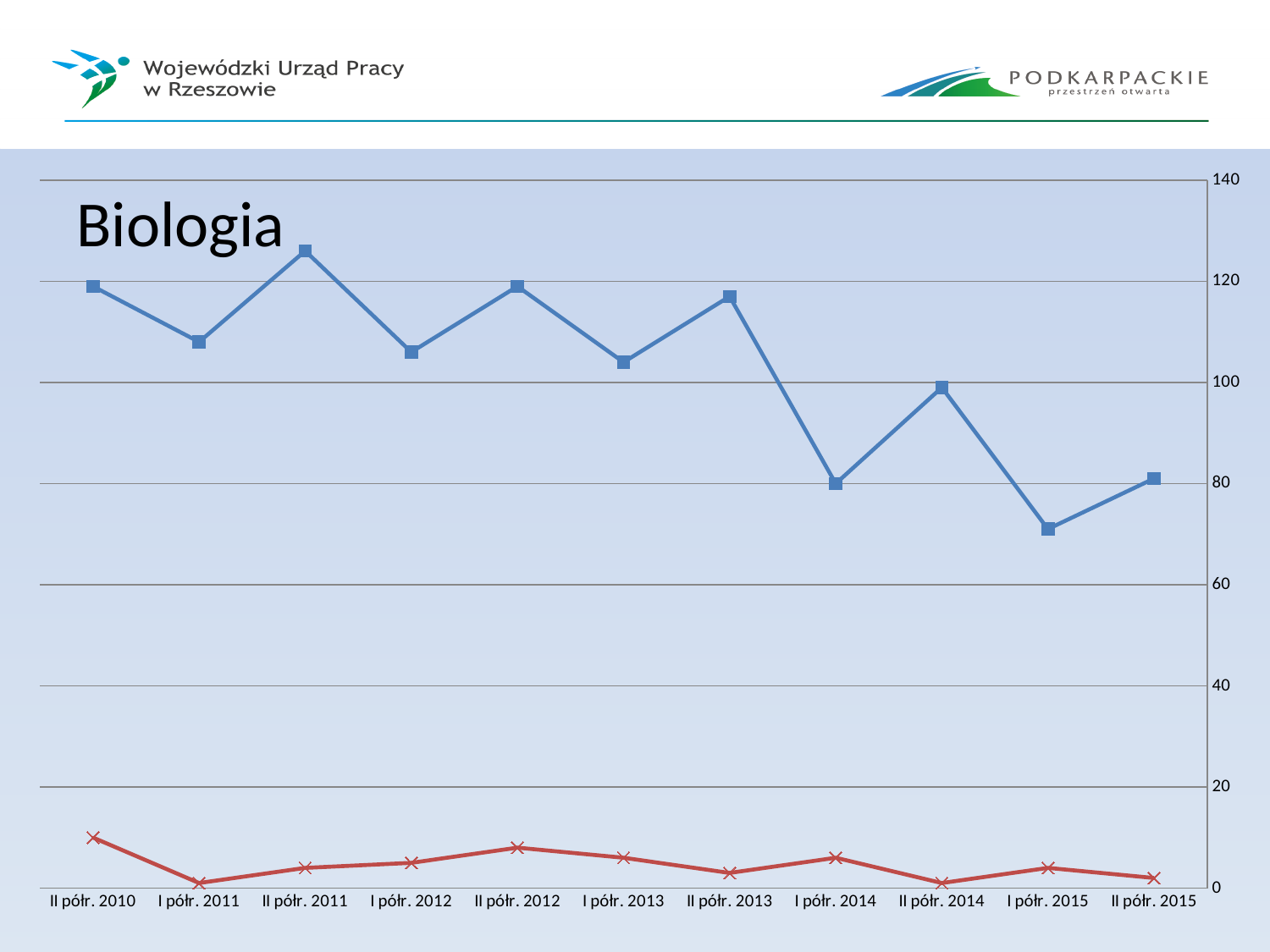
In which period does the blue line (square markers) reach its highest value? II półr. 2011 For the blue line, which is larger: the value for II półr. 2013 or the value for I półr. 2014? II półr. 2013 Is the value of the red line for II półr. 2012 greater or less than 20? less How many periods (categories) are shown on the x axis? 11 What kind of chart is shown on the slide? line chart Is the value of the blue line for II półr. 2011 greater or less than 120? greater What is the title of the chart? Biologia In which period does the blue line (square markers) reach its lowest value? I półr. 2015 Is the value of the blue line for I półr. 2015 greater or less than 80? less How many lines are plotted on the chart? 2 Overall, does the blue line rise or fall from II półr. 2010 to II półr. 2015? fall In which period does the red line (x markers) reach its highest value? II półr. 2010